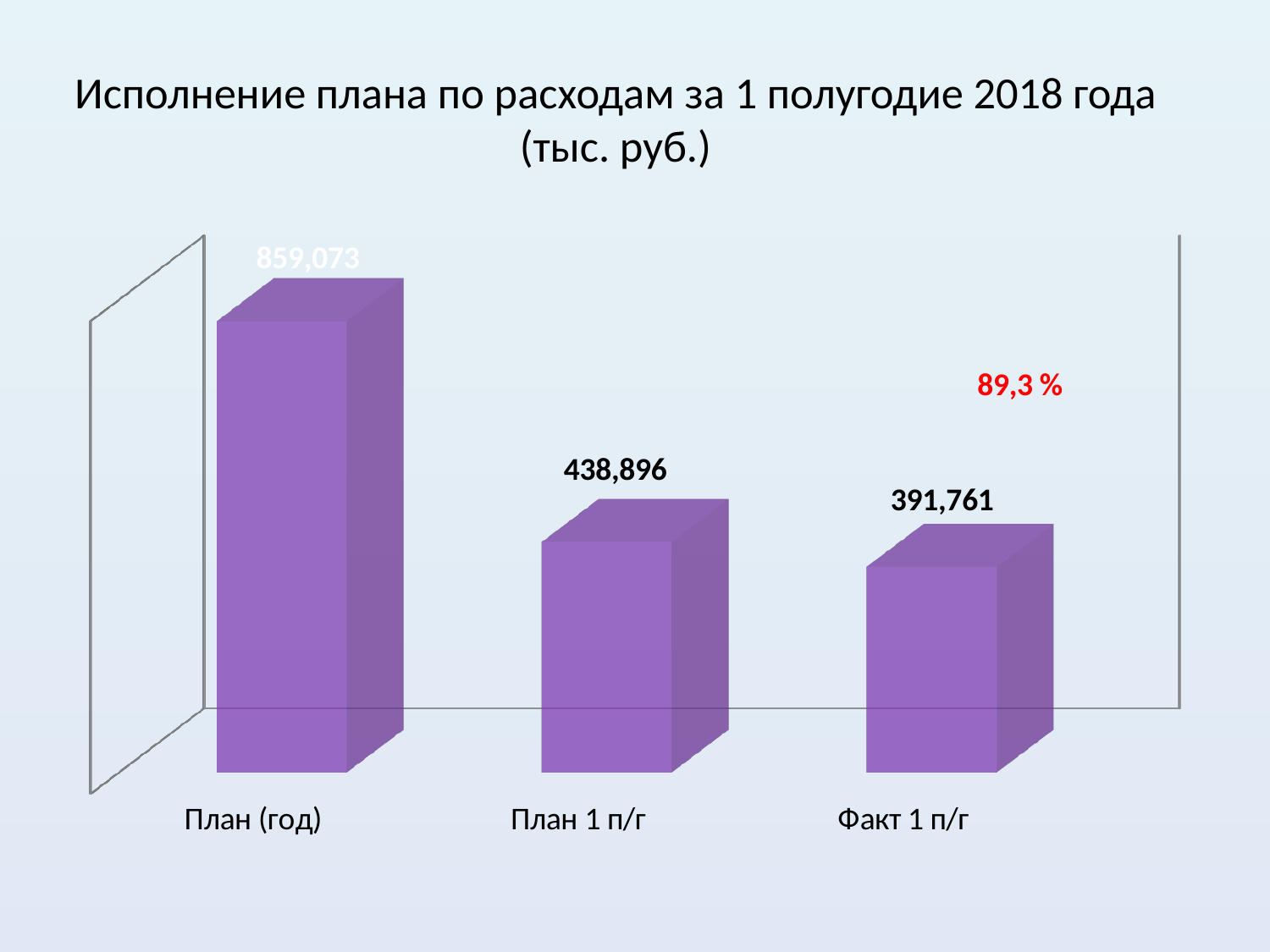
What is the value for План 1 п/г? 438,896 What percentage is printed in red on the chart? 89,3 % Which category has the lowest value? Факт 1 п/г What kind of chart is shown on the slide? Bar chart What is the value for Факт 1 п/г? 391,761 Which category has the highest value? План (год) What is the value for План (год)? 859,073 Do the values rise or fall from left to right across the categories? Fall What is the difference between План (год) and План 1 п/г? 420,177 Which is larger, План 1 п/г or Факт 1 п/г? План 1 п/г How many categories are shown in the chart? 3 What is the difference between План 1 п/г and Факт 1 п/г? 47,135